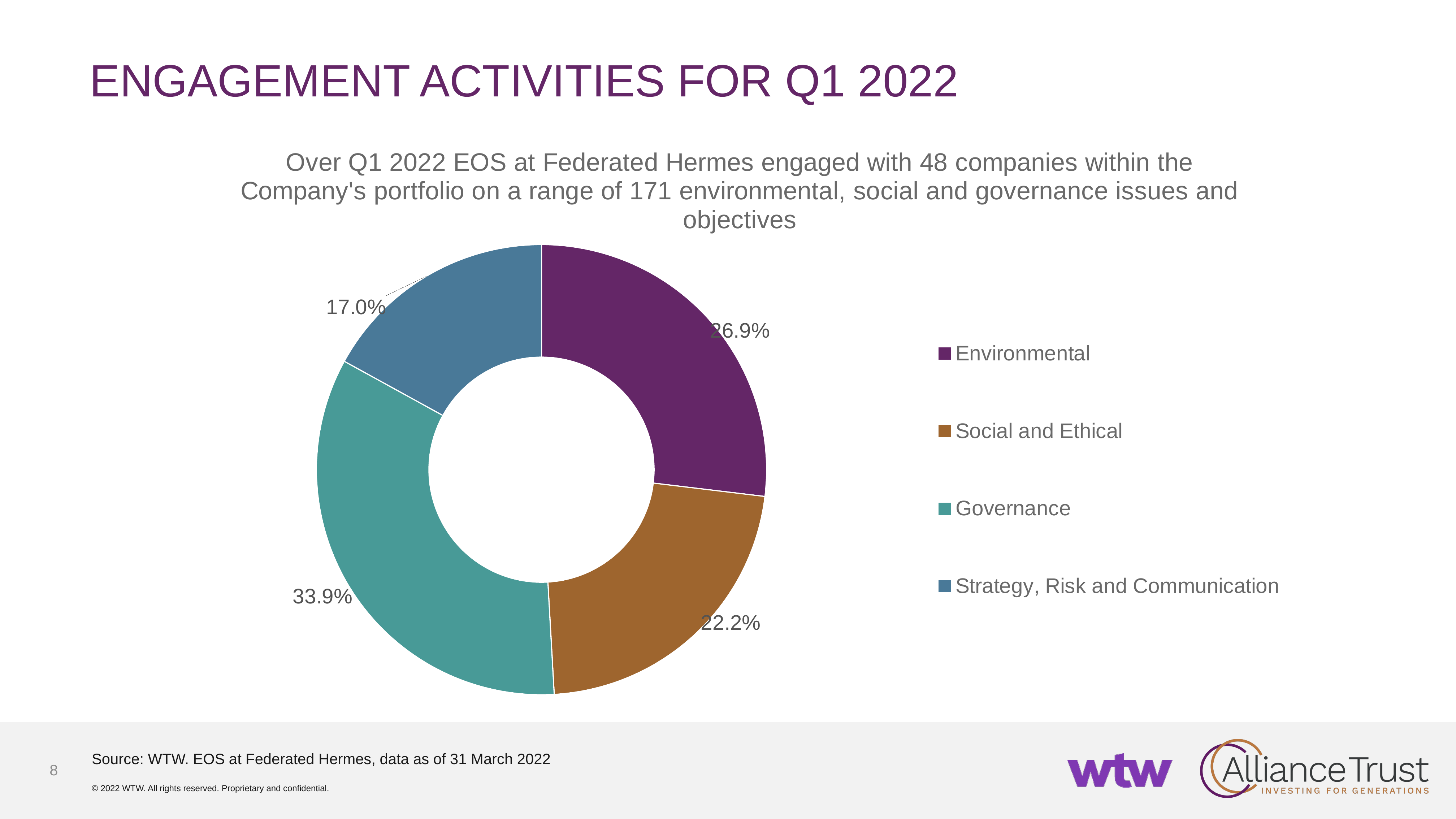
What percentage is shown for Social and Ethical? 22.2% What share of engagement issues does the Governance slice represent? 33.9% What is the difference in percentage points between Governance and Environmental? 7.0 Which category has the largest share of the chart? Governance How many categories are shown in the chart? 4 According to the chart title, how many companies did EOS at Federated Hermes engage with over Q1 2022? 48 What colour is the Governance slice? Teal What kind of chart is shown on the slide? Pie chart (doughnut) What percentage is shown for Strategy, Risk and Communication? 17.0% What percentage is shown for the Environmental slice? 26.9% Which is larger, the Environmental share or the Social and Ethical share? Environmental Which category has the smallest share of the chart? Strategy, Risk and Communication